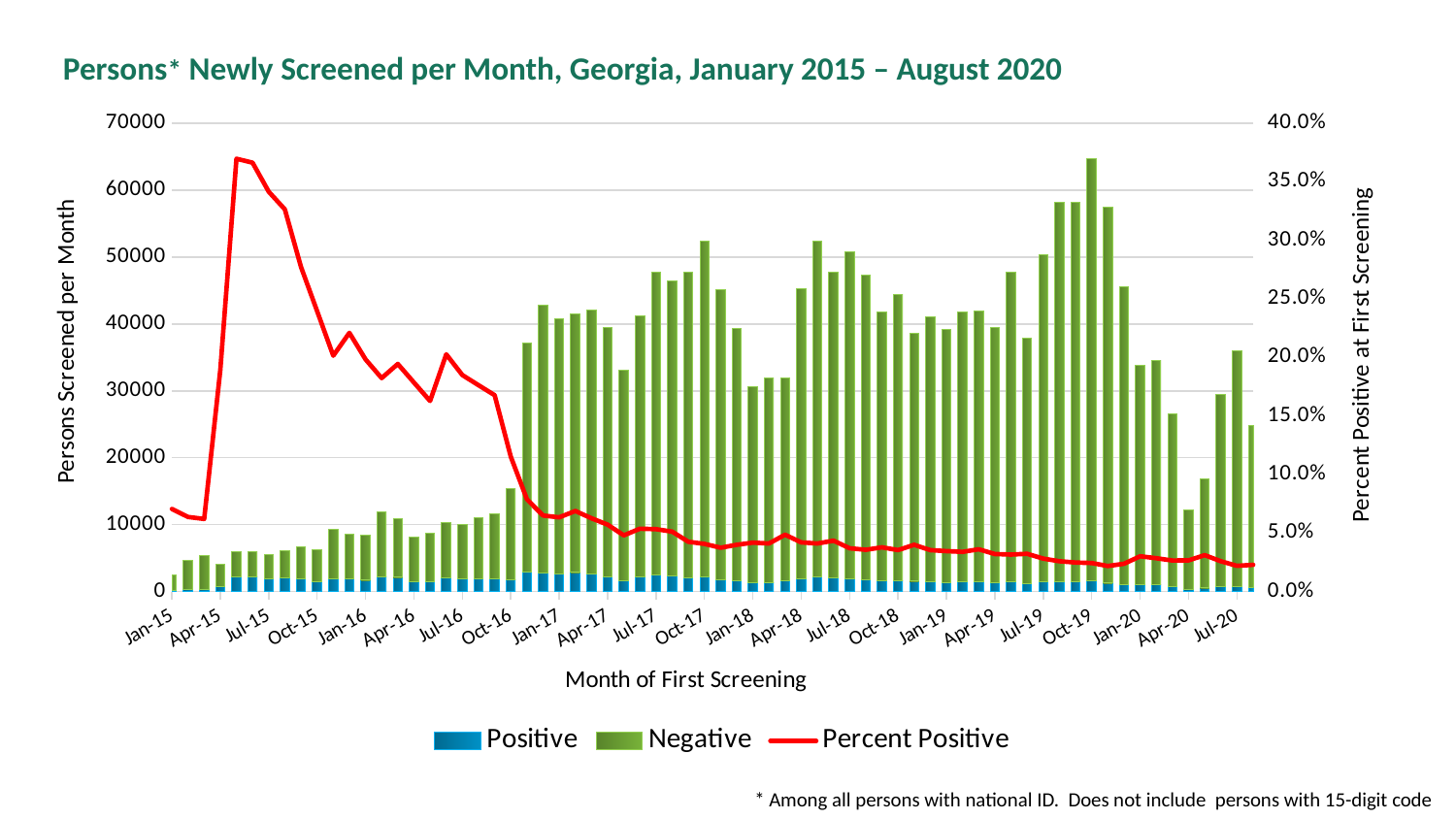
How many series does the legend list? 3 Does the Percent Positive line generally rise or fall from Jul-15 to Jan-17? fall Is the total number of persons screened in Jan-20 greater or less than 30000? greater Which month has the larger Percent Positive value, Jul-15 or Jul-20? Jul-15 Is the total number of persons screened in Jan-15 greater or less than 10000? less What are the three series named in the legend? Positive, Negative, Percent Positive What kind of chart is shown on the slide? A combined bar and line chart (stacked bars with a line) What is the title of the right-hand vertical axis? Percent Positive at First Screening Is the peak of the Percent Positive line greater or less than 35.0%? greater